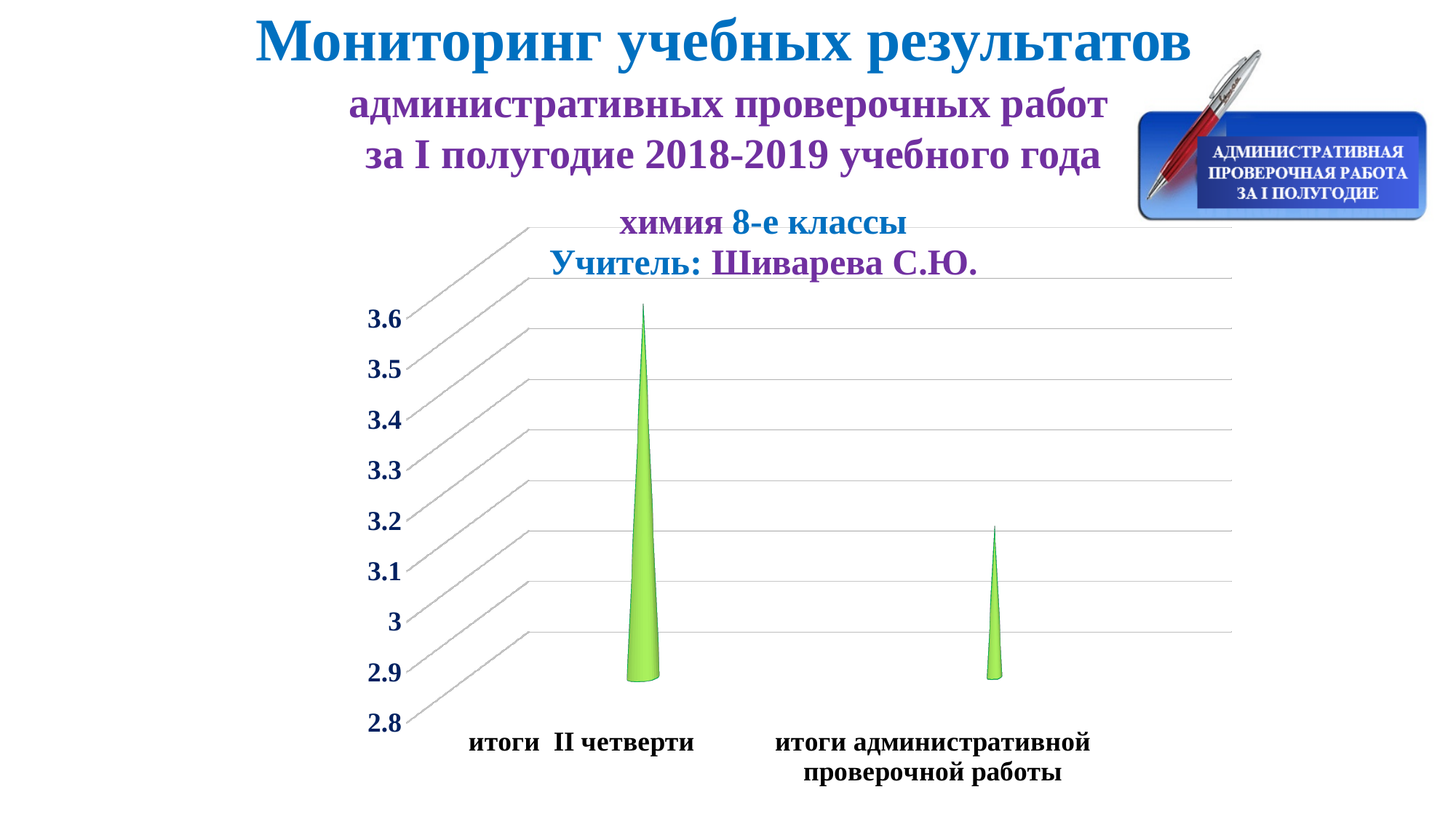
Which category has the highest value on the chart? итоги II четверти Which subject and classes does the chart title refer to? химия 8-е классы How many categories are plotted on the chart? 2 Is the value for итоги административной проверочной работы greater or less than 3.4? less Which category has the lowest value on the chart? итоги административной проверочной работы Which is larger: the value for итоги II четверти or the value for итоги административной проверочной работы? итоги II четверти Is the value for итоги II четверти greater or less than 3.4? greater What kind of chart is shown on the slide? bar chart Do the values rise or fall from the first category to the second along the x axis? fall What is the lowest value shown on the vertical axis of the chart? 2.8 Is the value for итоги административной проверочной работы greater or less than 3? greater